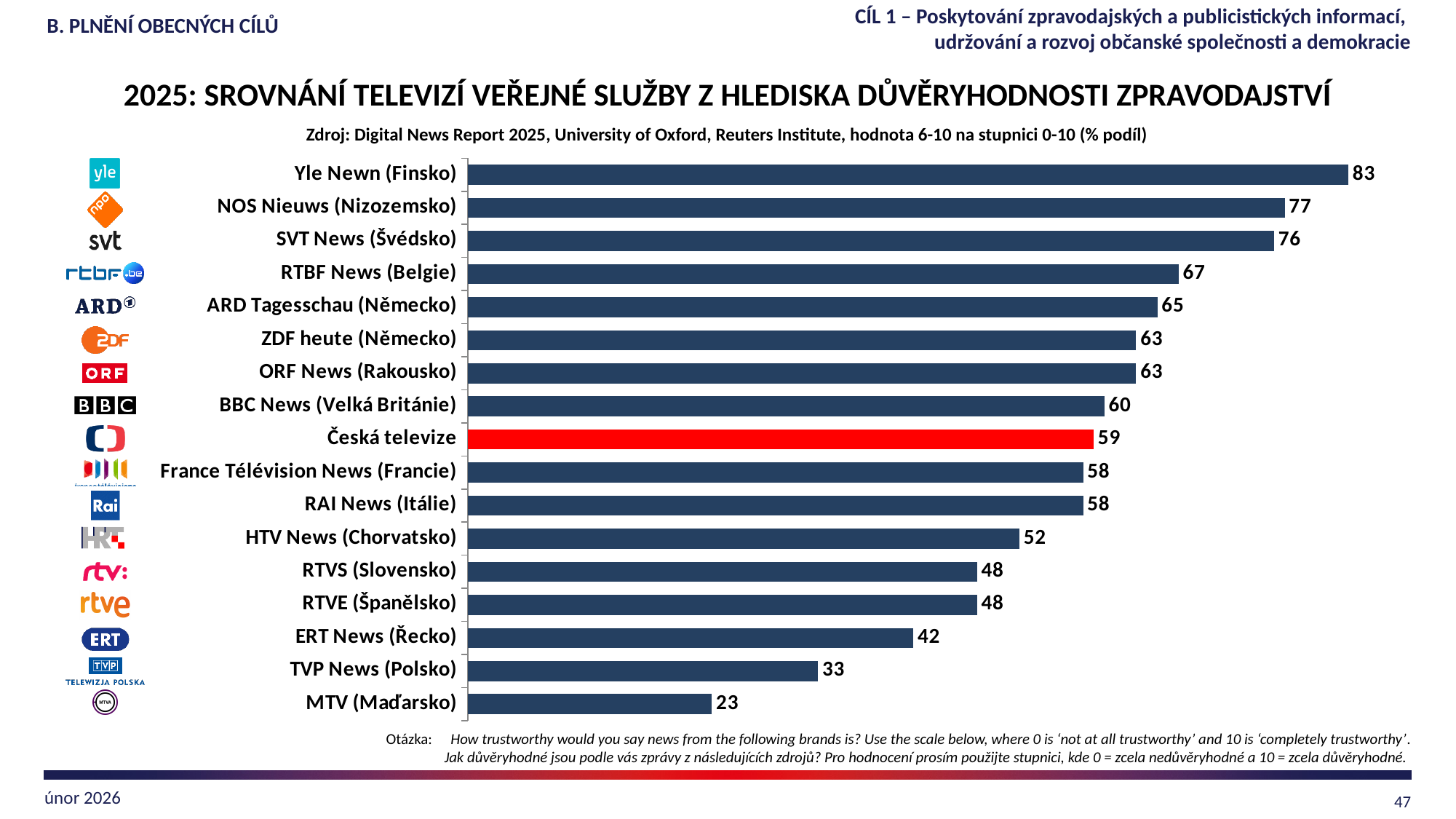
What kind of chart is shown on the slide? Bar chart Which bar is highlighted in red? Česká televize Which has a larger value, HTV News (Chorvatsko) or RTVS (Slovensko)? HTV News (Chorvatsko) What is the value for BBC News (Velká Británie)? 60 What is the difference between the values for Yle Newn (Finsko) and Česká televize? 24 What is the value for Česká televize? 59 What is the value for TVP News (Polsko)? 33 How many broadcasters are shown in the chart? 17 Which broadcaster has the highest value? Yle Newn (Finsko) Which has a larger value, RTBF News (Belgie) or ARD Tagesschau (Německo)? RTBF News (Belgie) What is the difference between the values for ERT News (Řecko) and MTV (Maďarsko)? 19 Which broadcaster has the lowest value? MTV (Maďarsko)